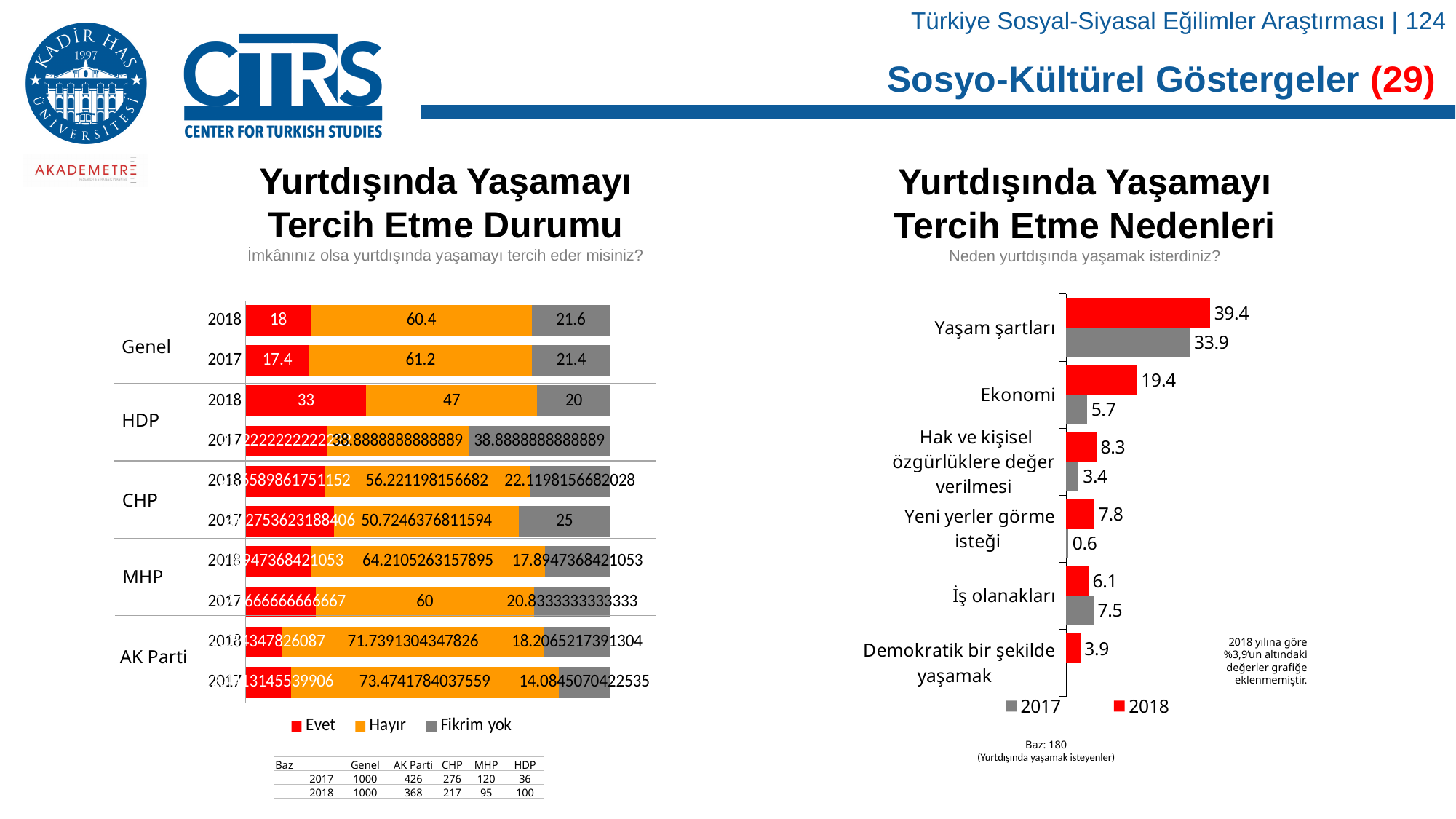
In the chart 'Yurtdışında Yaşamayı Tercih Etme Durumu', how many series does the legend list? 3 In the chart 'Yurtdışında Yaşamayı Tercih Etme Nedenleri', what is the 2018 value for Yaşam şartları? 39.4 What kind of chart is 'Yurtdışında Yaşamayı Tercih Etme Nedenleri'? Bar chart In the chart 'Yurtdışında Yaşamayı Tercih Etme Nedenleri', for İş olanakları, which year has the larger value, 2017 or 2018? 2017 In the chart 'Yurtdışında Yaşamayı Tercih Etme Durumu', what is the 'Evet' value for Genel in 2018? 18 In the chart 'Yurtdışında Yaşamayı Tercih Etme Durumu', which colour represents 'Hayır'? Orange In the chart 'Yurtdışında Yaşamayı Tercih Etme Nedenleri', which reason has the highest 2018 value? Yaşam şartları In the chart 'Yurtdışında Yaşamayı Tercih Etme Durumu', what is the 'Fikrim yok' value for CHP in 2017? 25 In the chart 'Yurtdışında Yaşamayı Tercih Etme Nedenleri', what is the difference between the 2018 and 2017 values for Ekonomi? 13.7 In the chart 'Yurtdışında Yaşamayı Tercih Etme Durumu', what is the total of the Genel 2017 bar? 100 In the chart 'Yurtdışında Yaşamayı Tercih Etme Durumu', what is the 'Hayır' value for HDP in 2018? 47 In the chart 'Yurtdışında Yaşamayı Tercih Etme Nedenleri', what is the 2017 value for Ekonomi? 5.7